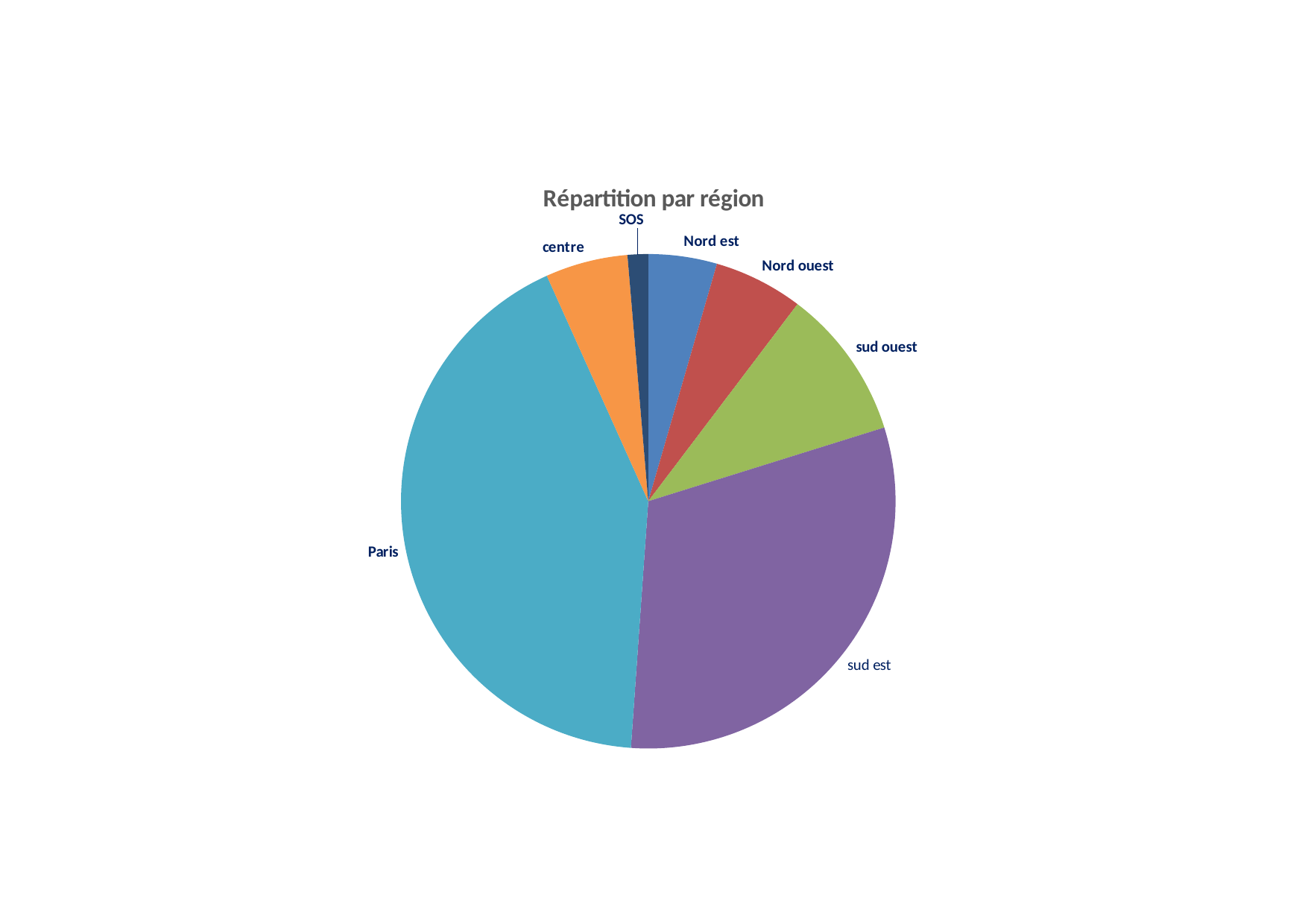
Which region has the largest slice of the pie? Paris What kind of chart is shown on the slide? pie chart Which region has the smallest slice of the pie? SOS Which slice is larger, Paris or sud est? Paris Which slice is larger, sud est or sud ouest? sud est How many slices does the pie chart have? 7 Which region has the second-largest slice of the pie? sud est Which slice is larger, sud ouest or Nord ouest? sud ouest What colour is the Paris slice? teal (light blue) What is the title of the chart? Répartition par région